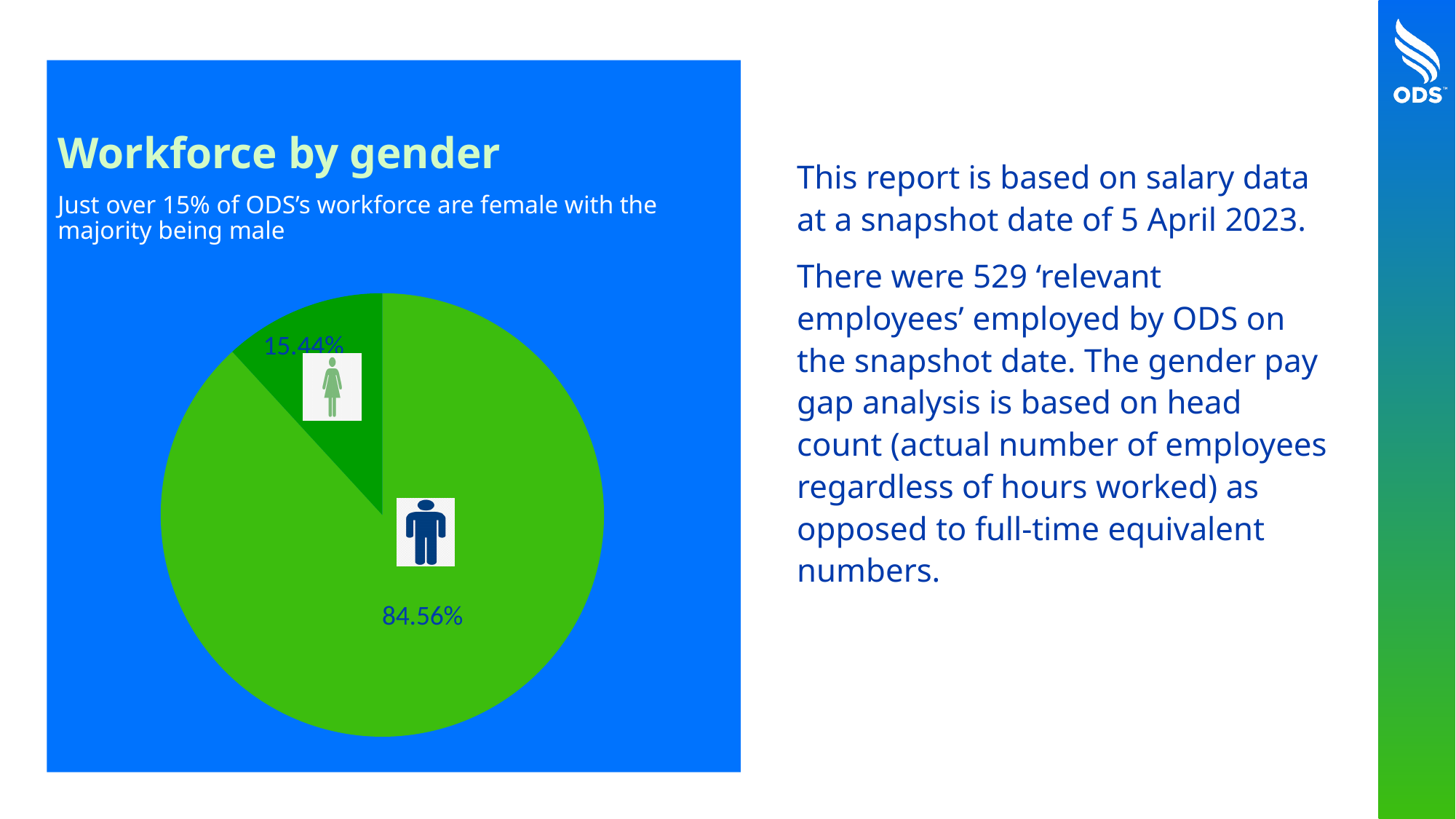
What percentage of the workforce is male according to the pie chart? 84.56% Is the male share of the workforce greater or less than 80%? greater What is the difference in percentage points between the male and female shares? 69.12 Which slice is larger: the one with the female icon or the one with the male icon? the one with the male icon Which gender has the smaller share of the workforce? female How many slices does the pie chart have? 2 What kind of chart is shown on the slide? pie chart What do the two slices of the pie chart add up to? 100% What percentage of the workforce is female according to the pie chart? 15.44% What is the title of the chart? Workforce by gender Which gender has the larger share of the workforce? male Is the female share of the workforce greater or less than 20%? less